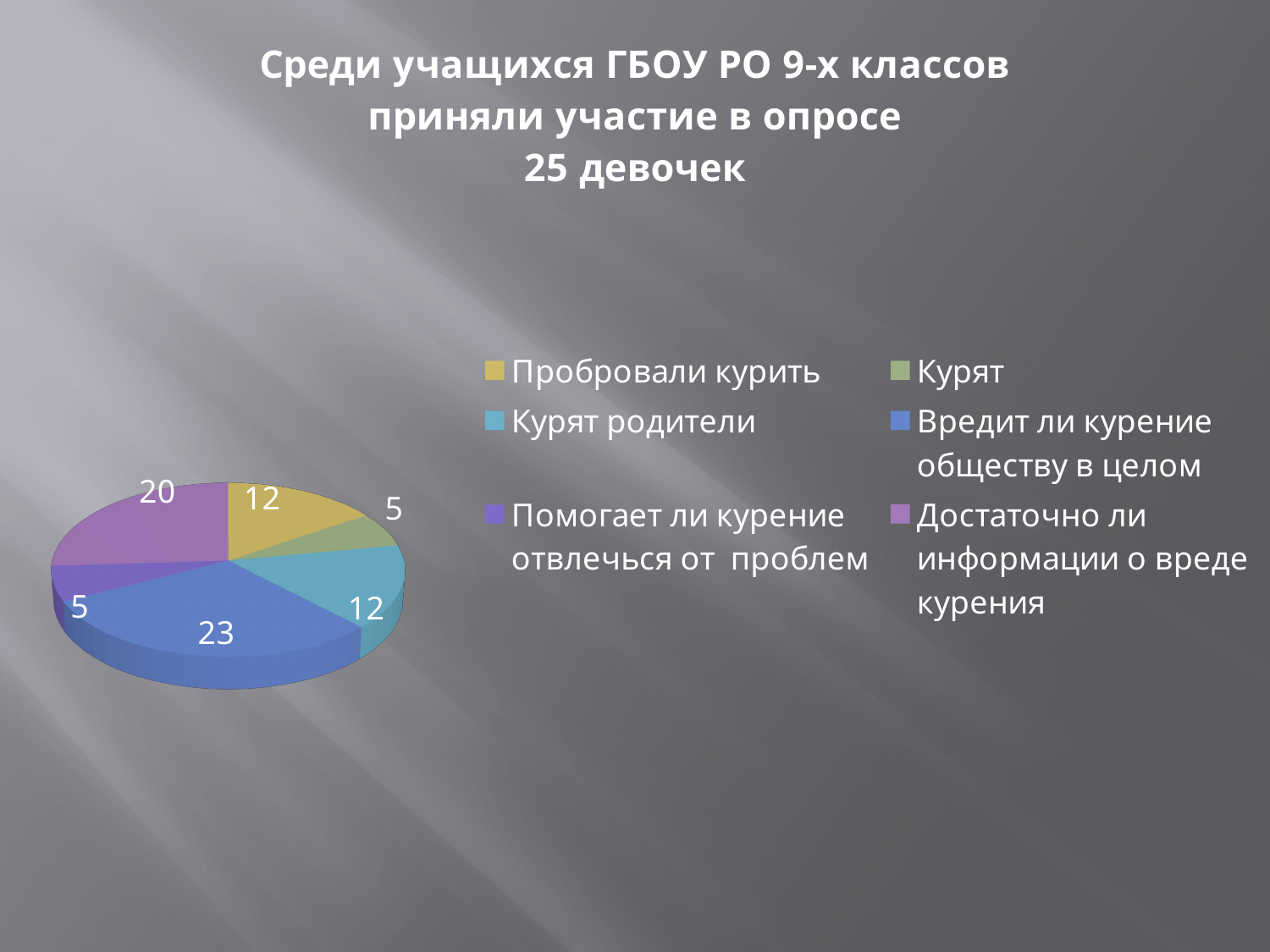
What kind of chart is shown on the slide? pie chart How many slices does the pie chart have? 6 What is the difference between the values for "Вредит ли курение обществу в целом" and "Достаточно ли информации о вреде курения"? 3 What is the value for "Достаточно ли информации о вреде курения"? 20 How many entries does the legend list? 6 What is the value for "Вредит ли курение обществу в целом"? 23 What is the value for "Курят"? 5 What is the value for "Курят родители"? 12 What is the difference between the values for "Достаточно ли информации о вреде курения" and "Пробровали курить"? 8 Which is larger: the value for "Курят родители" or the value for "Курят"? Курят родители Which category has the largest slice of the pie? Вредит ли курение обществу в целом What is the value for "Помогает ли курение отвлечься от проблем"? 5